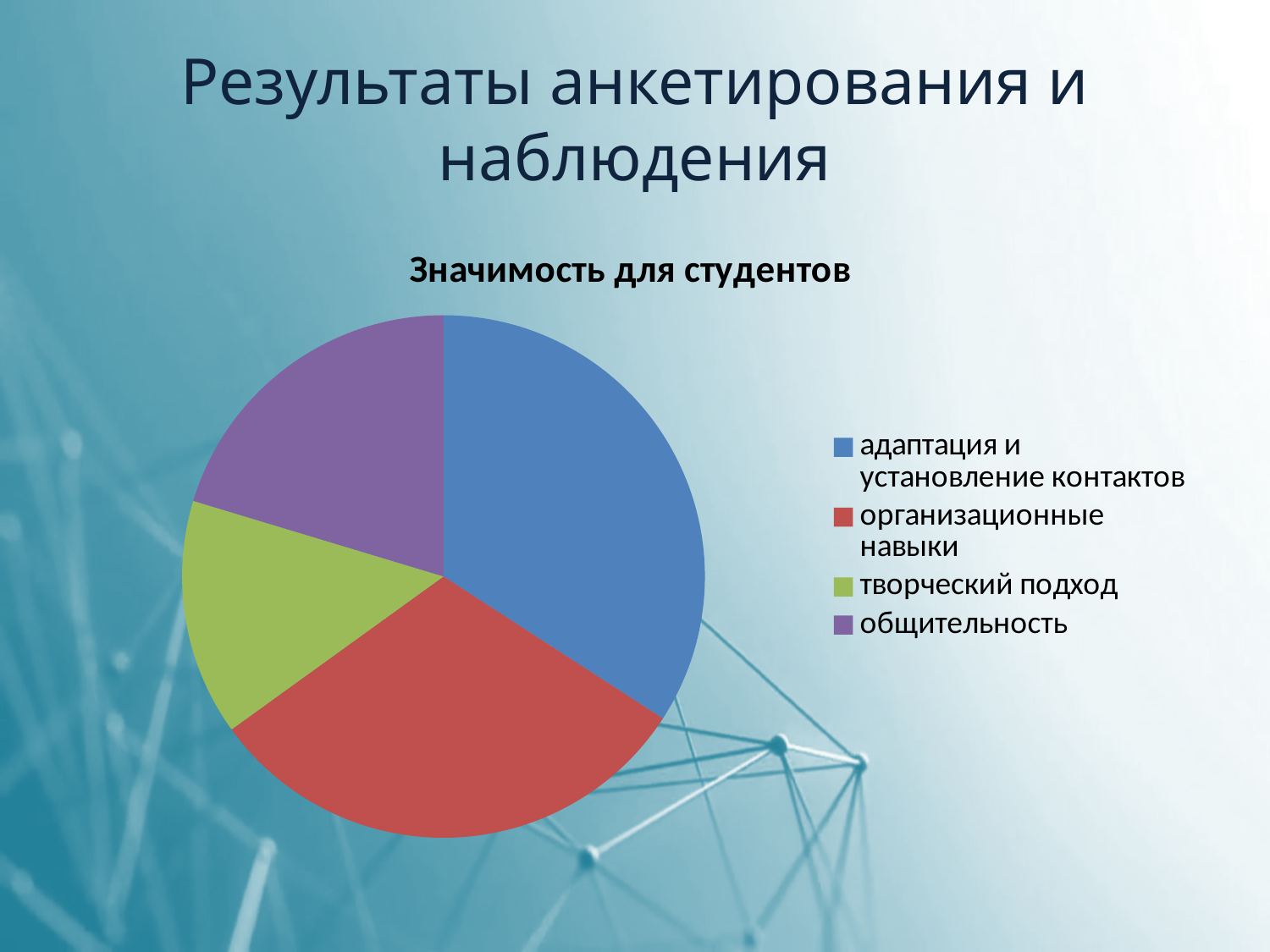
What colour is the slice for организационные навыки? red Which category has the largest slice of the pie? адаптация и установление контактов How many entries does the legend list? 4 Which category has the smallest slice of the pie? творческий подход What kind of chart is shown on the slide? pie chart Which slice is larger: организационные навыки or общительность? организационные навыки How many categories (slices) does the pie chart have? 4 Which slice is larger: творческий подход or общительность? общительность Which slice is larger: адаптация и установление контактов or творческий подход? адаптация и установление контактов What is the title of the chart? Значимость для студентов